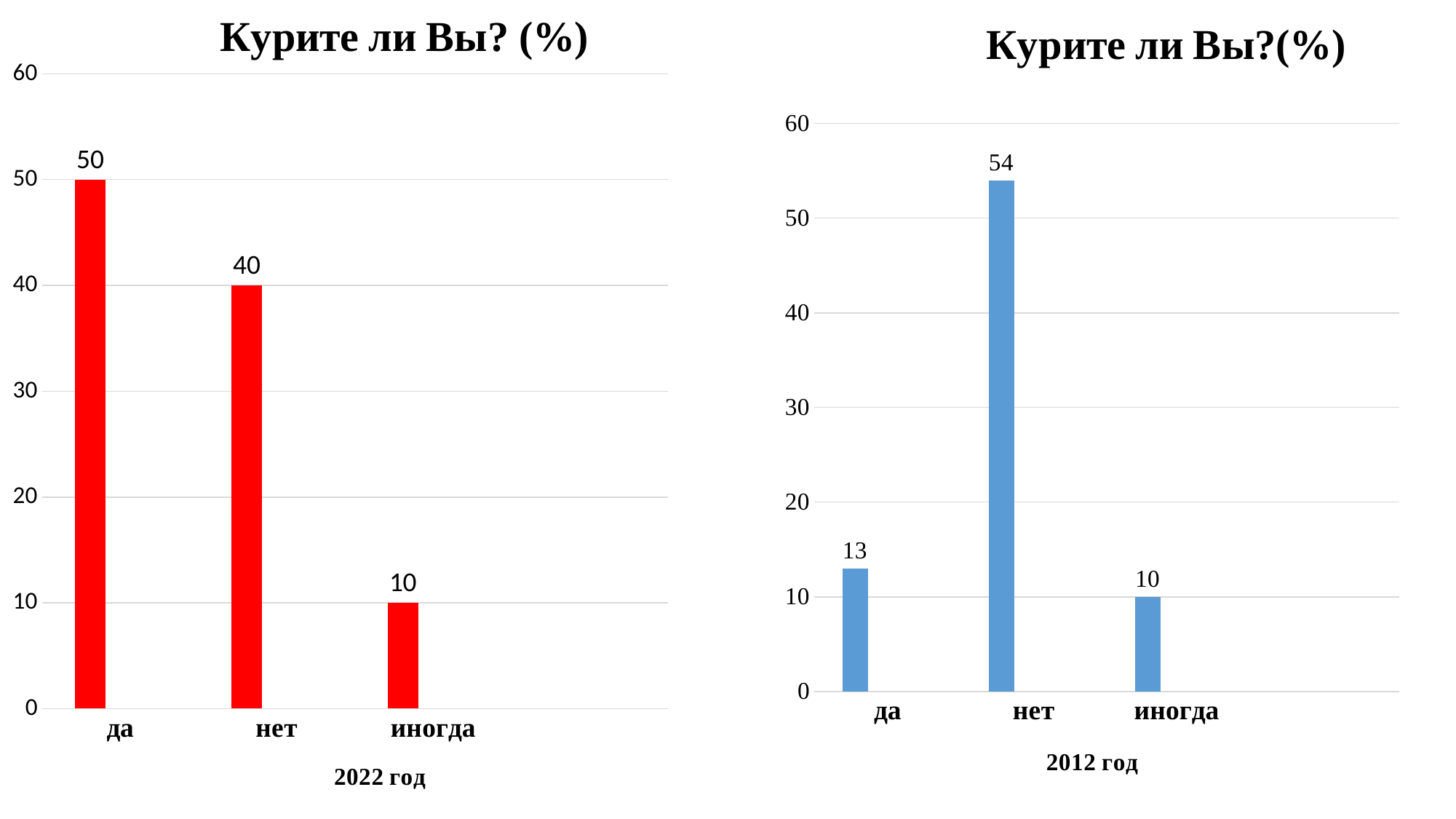
In the left chart (2022 год), which category has the highest value? да In the left chart (2022 год), what is the value for "да"? 50 What colour are the bars in the left chart (2022 год)? red In the left chart (2022 год), what is the difference between the values for "да" and "нет"? 10 In the right chart (2012 год), what is the difference between the values for "нет" and "да"? 41 What type of chart is the right chart (2012 год)? bar chart In the right chart (2012 год), which is larger, the value for "да" or the value for "иногда"? да In the right chart (2012 год), what is the value for "нет"? 54 In the left chart (2022 год), what is the value for "иногда"? 10 How many categories are shown in the left chart (2022 год)? 3 In the right chart (2012 год), which category has the lowest value? иногда In the right chart (2012 год), what is the value for "да"? 13